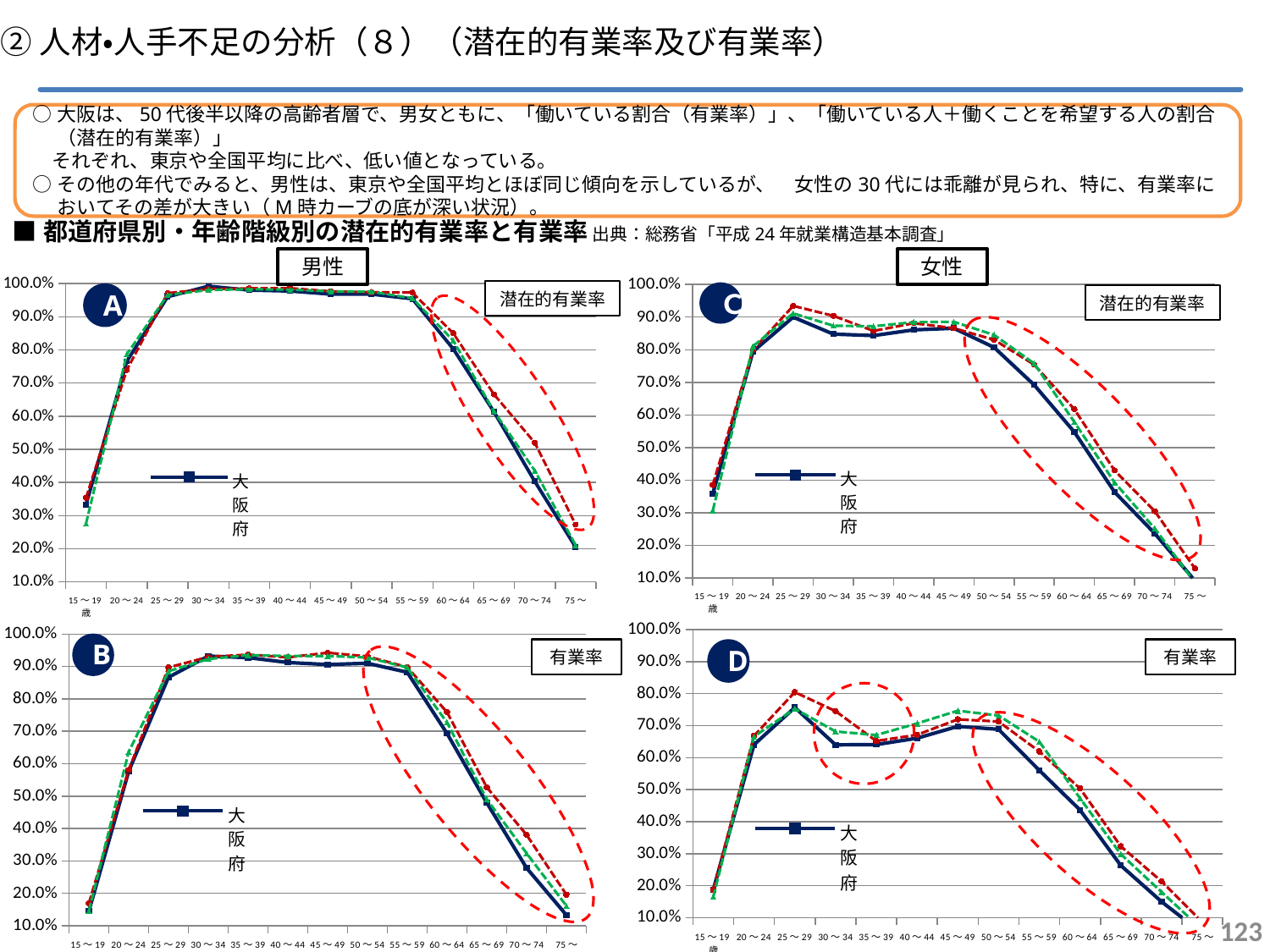
In chart A (男性 潜在的有業率), is the value for 大阪府 at 15～19歳 greater or less than 40%? less In chart C (女性 潜在的有業率), which age category has the lowest value for 大阪府? 75～ In chart B (男性 有業率), is the value for 大阪府 at 55～59 greater or less than 80%? greater In chart D (女性 有業率), which age category has the highest value for 大阪府? 25～29 Which series is named in the legend of chart D (女性 有業率)? 大阪府 In chart A (男性 潜在的有業率), do the values for 大阪府 rise or fall from 55～59 to 75～? fall What kind of chart is chart A (男性 潜在的有業率)? Line chart In chart B (男性 有業率), is the value for 大阪府 at 15～19 greater or less than 20%? less In chart A (男性 潜在的有業率), which age category has the lowest value for 大阪府? 75～ How many age categories are shown on the x axis of chart B (男性 有業率)? 13